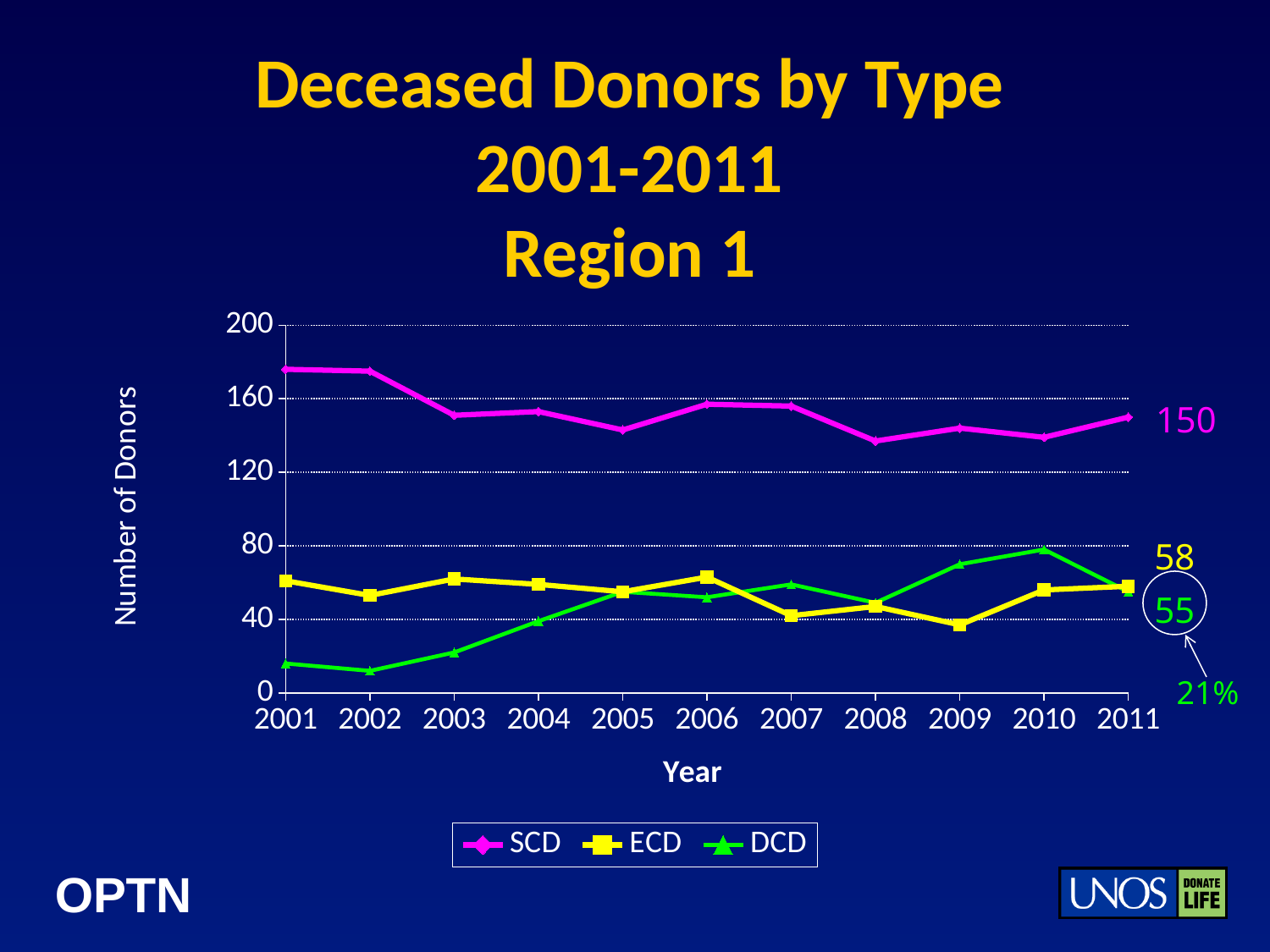
What is the value for ECD in 2011? 58 Is the value for DCD in 2001 greater or less than 40? less How many years are plotted on the x axis? 11 What is the value for SCD in 2011? 150 What percentage is shown next to the DCD value for 2011? 21% What is the value for DCD in 2011? 55 What is the difference between the SCD and ECD values in 2011? 92 Does the DCD line generally rise or fall from 2001 to 2011? Rise Is the value for SCD in 2001 greater or less than 160? greater In 2011, which is larger, ECD or DCD? ECD How many series does the legend list? 3 What kind of chart is shown? Line chart